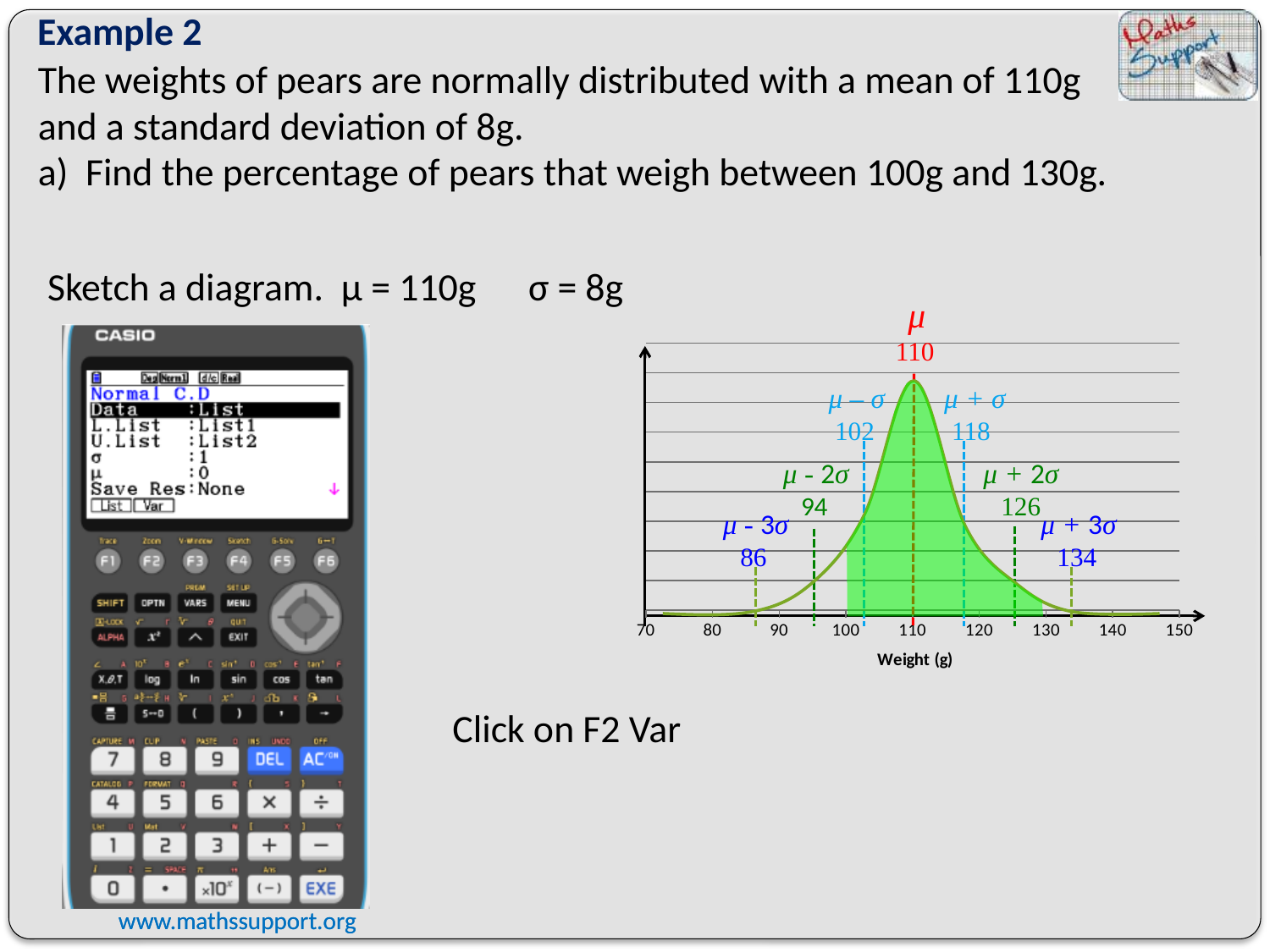
What value is labelled at μ - 3σ on the chart? 86 What value is labelled at μ + σ on the chart? 118 Which is larger, the value labelled at μ + 2σ or the value labelled at μ - 2σ? μ + 2σ What is the title of the horizontal axis of the chart? Weight (g) What value is labelled at μ - σ on the chart? 102 What is the difference between the values labelled at μ + 3σ and μ - 3σ? 48 What value is labelled at μ + 2σ on the chart? 126 What are the lowest and highest tick values shown on the horizontal axis? 70 and 150 Between which two horizontal-axis values is the region under the curve shaded green? 100 and 130 What is the difference between the values labelled at μ + σ and μ - σ? 16 What value is labelled at μ + 3σ on the chart? 134 What value is labelled at the peak of the curve, marked μ? 110